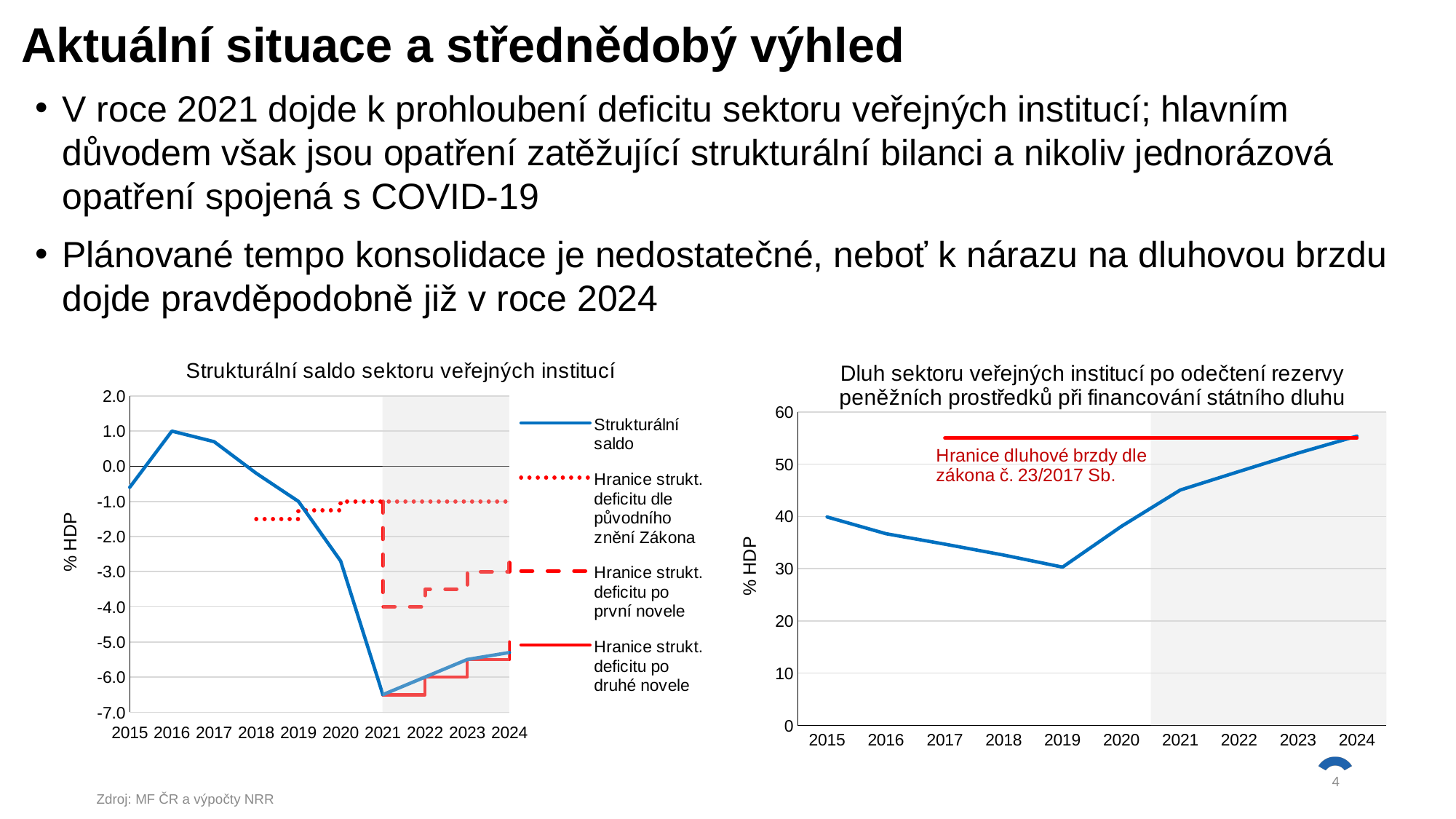
In the right chart 'Dluh sektoru veřejných institucí', does the debt line rise or fall between 2019 and 2024? rise In the right chart 'Dluh sektoru veřejných institucí', which year has the larger value, 2015 or 2024? 2024 In the right chart 'Dluh sektoru veřejných institucí', in which year is the debt line at its lowest? 2019 In the left chart 'Strukturální saldo sektoru veřejných institucí', in which year is the 'Strukturální saldo' line at its highest? 2016 In the left chart 'Strukturální saldo sektoru veřejných institucí', is the 'Strukturální saldo' value for 2020 greater or less than -2.0? less In the right chart 'Dluh sektoru veřejných institucí', how many years are shown on the x axis? 10 In the left chart 'Strukturální saldo sektoru veřejných institucí', is the 'Strukturální saldo' value for 2021 greater or less than -6.0? less In the right chart 'Dluh sektoru veřejných institucí', is the value for 2021 greater or less than 40? greater What kind of chart is the right chart about 'Dluh sektoru veřejných institucí'? line chart In the left chart 'Strukturální saldo sektoru veřejných institucí', in which year is the 'Strukturální saldo' line at its lowest? 2021 In the left chart 'Strukturální saldo sektoru veřejných institucí', how many series does the legend list? 4 What kind of chart is the left chart titled 'Strukturální saldo sektoru veřejných institucí'? line chart